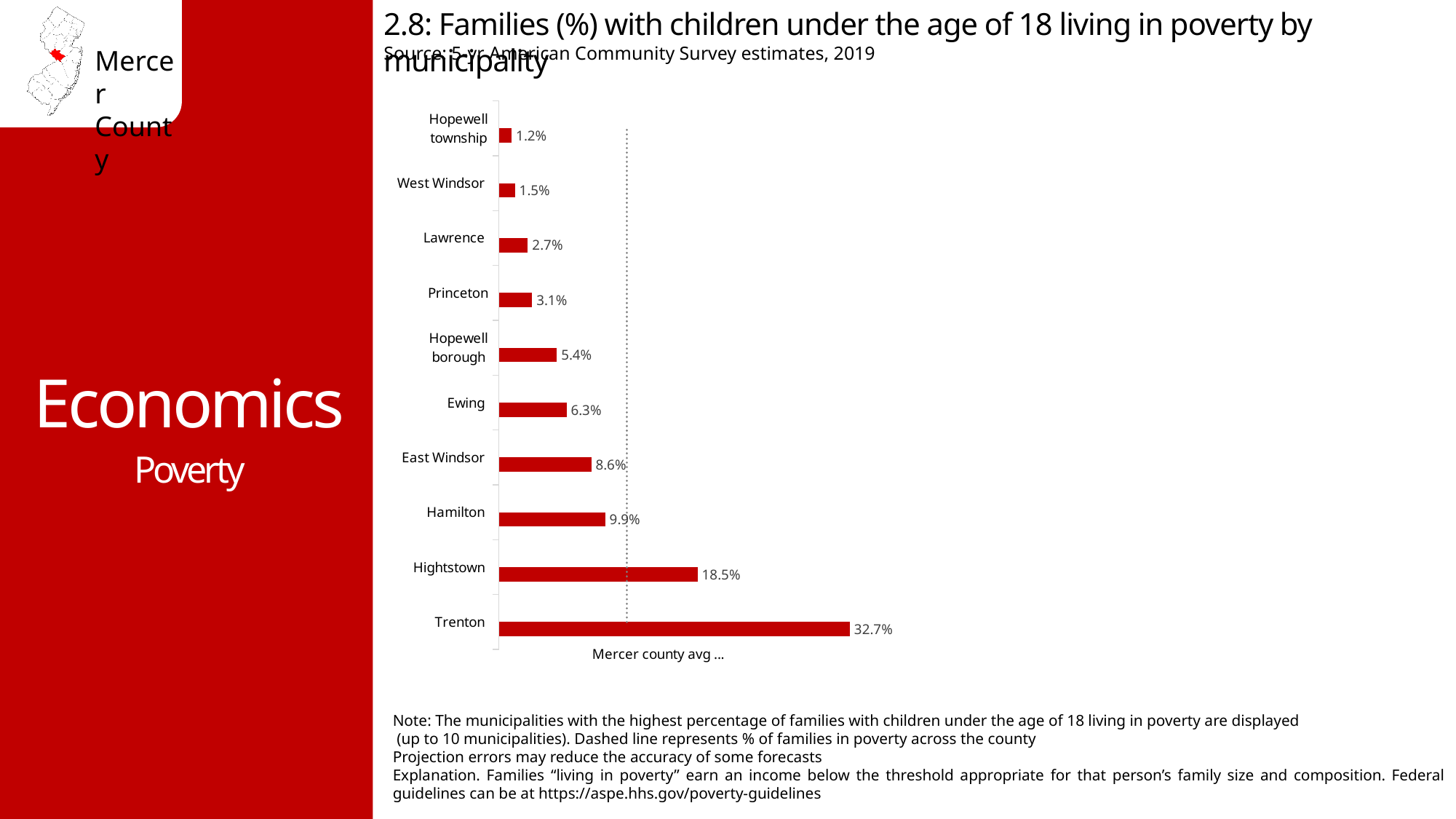
What is the difference between the values for Trenton and Hightstown? 14.2% What is the value shown for Hopewell borough? 5.4% What does the dashed vertical line in the chart represent? Mercer county average (% of families in poverty across the county) What is the value shown for Hamilton? 9.9% What percentage of families with children under 18 are living in poverty in Trenton? 32.7% What is the difference between the values for Ewing and Princeton? 3.2% What type of chart is used on this slide? Bar chart Which has a higher value, East Windsor or Ewing? East Windsor Which municipality has the lowest percentage of families with children living in poverty? Hopewell township Which has a lower value, West Windsor or Lawrence? West Windsor How many municipalities are shown in the chart? 10 Which municipality has the highest percentage of families with children living in poverty? Trenton